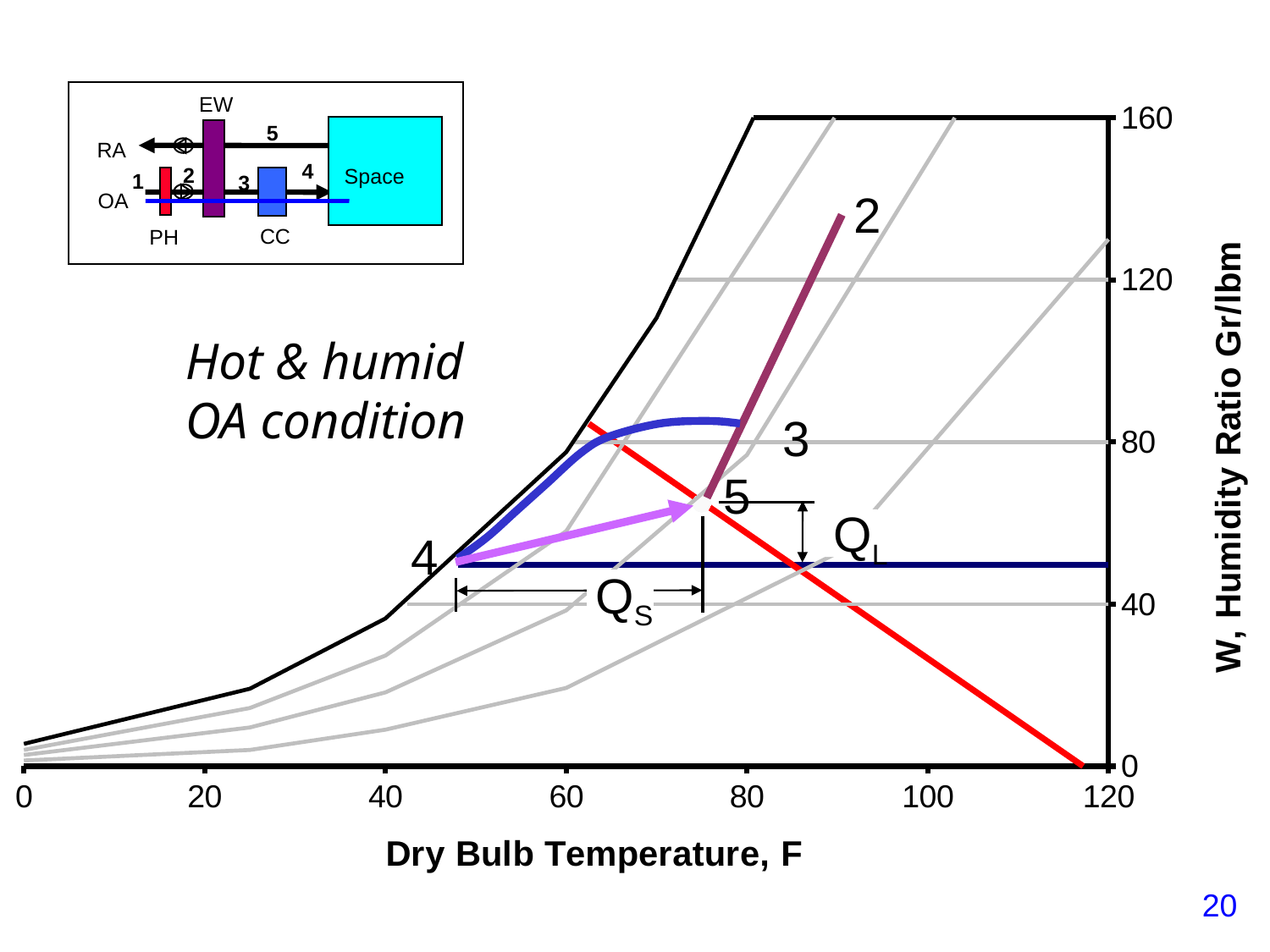
Which point has the higher humidity ratio, point 2 or point 4? Point 2 Which point has the higher dry bulb temperature, point 4 or point 5? Point 5 What is the highest value shown on the humidity ratio axis? 160 Is the dry bulb temperature at point 4 greater or less than 60? less Is the humidity ratio at point 2 greater or less than 120? greater How many numbered state points are labeled on the chart? 4 What is the label of the y axis of the chart? W, Humidity Ratio Gr/lbm What is the label of the x axis of the chart? Dry Bulb Temperature, F Is the humidity ratio at point 5 greater or less than 80? less Does the red line rise or fall as dry bulb temperature increases? fall